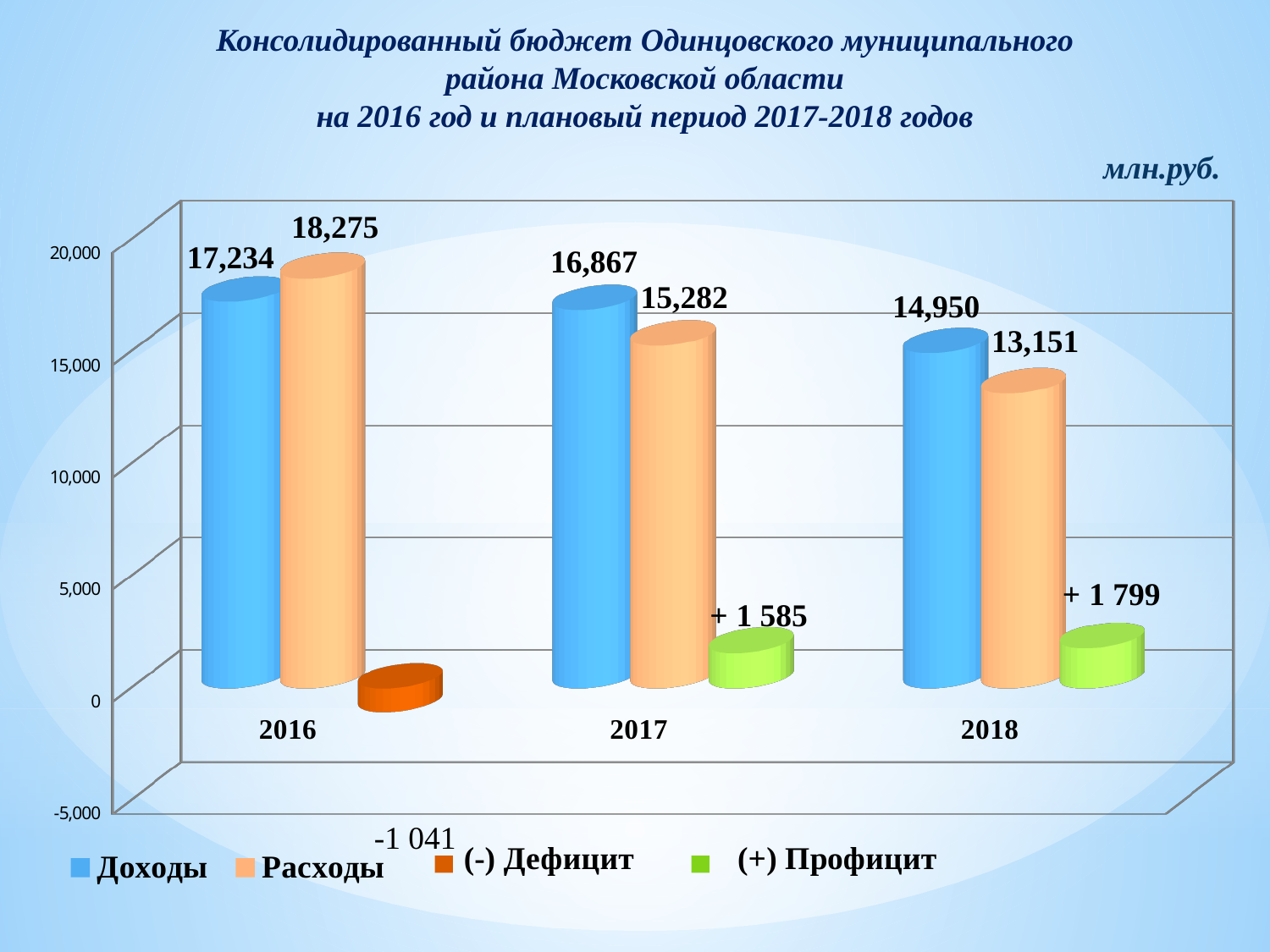
Do the Доходы values rise or fall from 2016 to 2018? Fall What kind of chart is shown on the slide? Bar chart In which year is Расходы highest? 2016 Which is larger in 2016, Доходы or Расходы? Расходы What is the value of (-) Дефицит for 2016? -1 041 What is the value of Доходы for 2016? 17,234 In which year is Доходы lowest? 2018 What is the value of (+) Профицит for 2017? + 1 585 How many series does the legend list? 4 What is the difference between Доходы and Расходы in 2017? 1,585 What is the value of Расходы for 2018? 13,151 How many years are shown on the x axis? 3